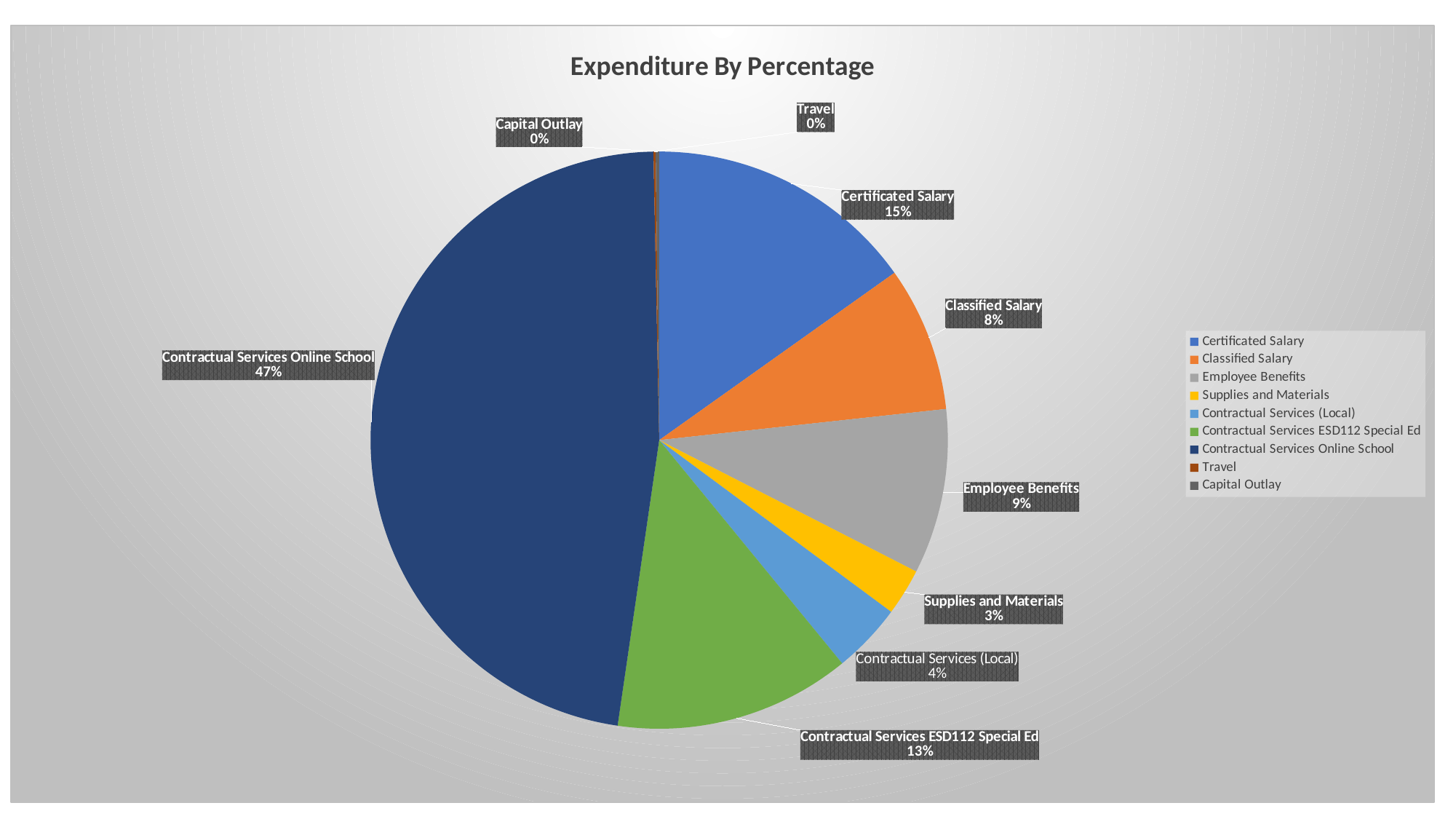
What percentage is shown for Travel? 0% Which category has the largest share of expenditure? Contractual Services Online School What colour is the Supplies and Materials slice? yellow What percentage of expenditure is Certificated Salary? 15% What is the title of the chart? Expenditure By Percentage What percentage of expenditure is Employee Benefits? 9% What is the difference in percentage points between Certificated Salary and Classified Salary? 7 What percentage of expenditure is Contractual Services ESD112 Special Ed? 13% How many categories does the legend list? 9 Which is larger, Supplies and Materials or Contractual Services (Local)? Contractual Services (Local) What percentage of expenditure is Contractual Services Online School? 47% What kind of chart is shown on the slide? pie chart